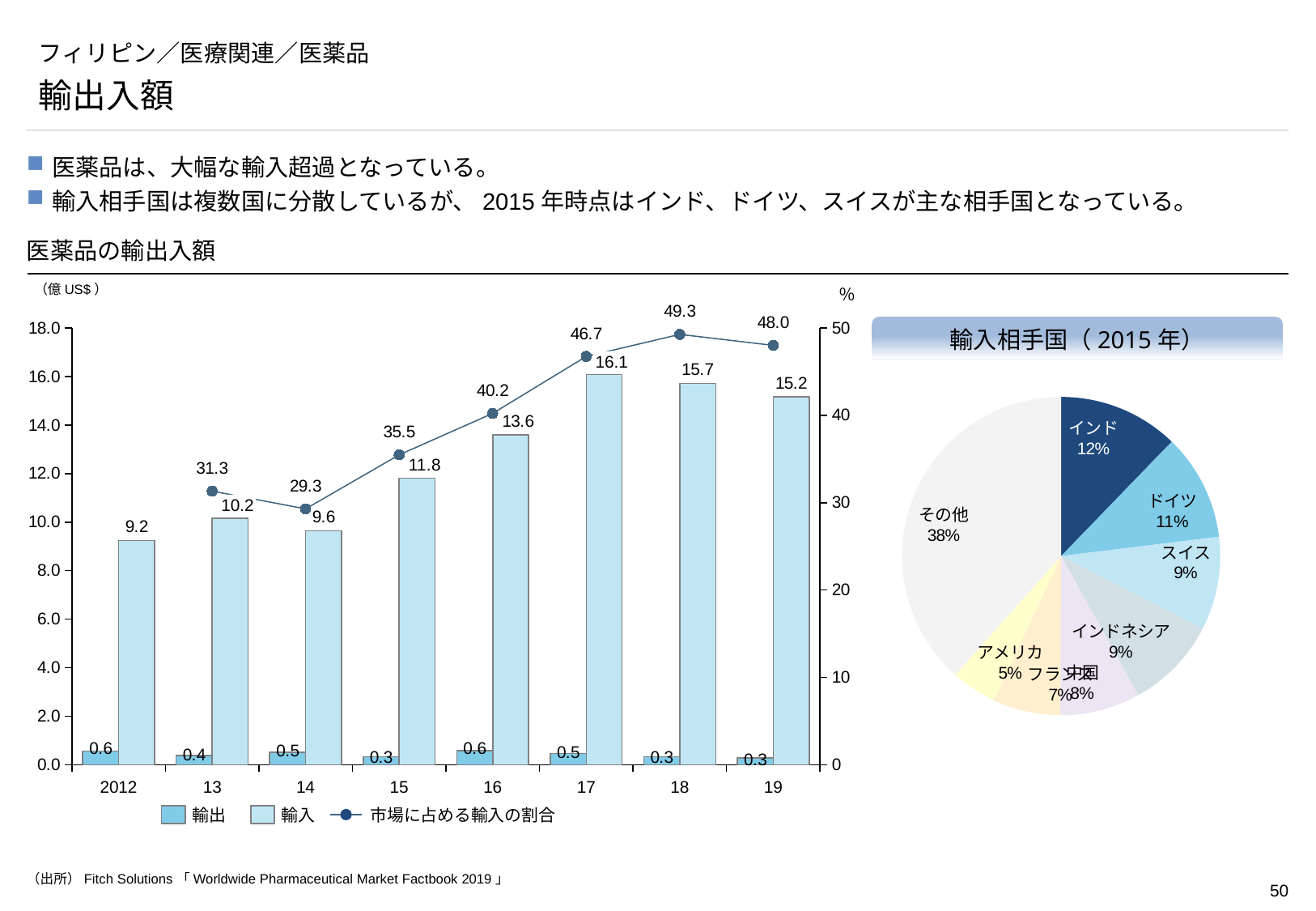
In the 医薬品の輸出入額 chart, does the 市場に占める輸入の割合 line rise or fall from 2014 to 2018? rise In the 医薬品の輸出入額 chart, what is the 輸入 value for 2017? 16.1 In the 医薬品の輸出入額 chart, how many series does the legend list? 3 In the 医薬品の輸出入額 chart, which year has the lowest 輸入 value? 2012 In the 医薬品の輸出入額 chart, which year has the highest 輸入 value? 2017 In the 医薬品の輸出入額 chart, which is larger, the 輸入 value for 2018 or for 2019? 2018 In the 医薬品の輸出入額 chart, what is the 市場に占める輸入の割合 value for 2018? 49.3 In the 輸入相手国（2015年） pie chart, what share does インド have? 12% In the 医薬品の輸出入額 chart, what is the difference between the 輸入 values for 2017 and 2012? 6.9 In the 医薬品の輸出入額 chart, how many years are shown on the x axis? 8 What kind of chart is the 輸入相手国（2015年） chart? pie chart In the 輸入相手国（2015年） pie chart, which named country has the largest share? インド